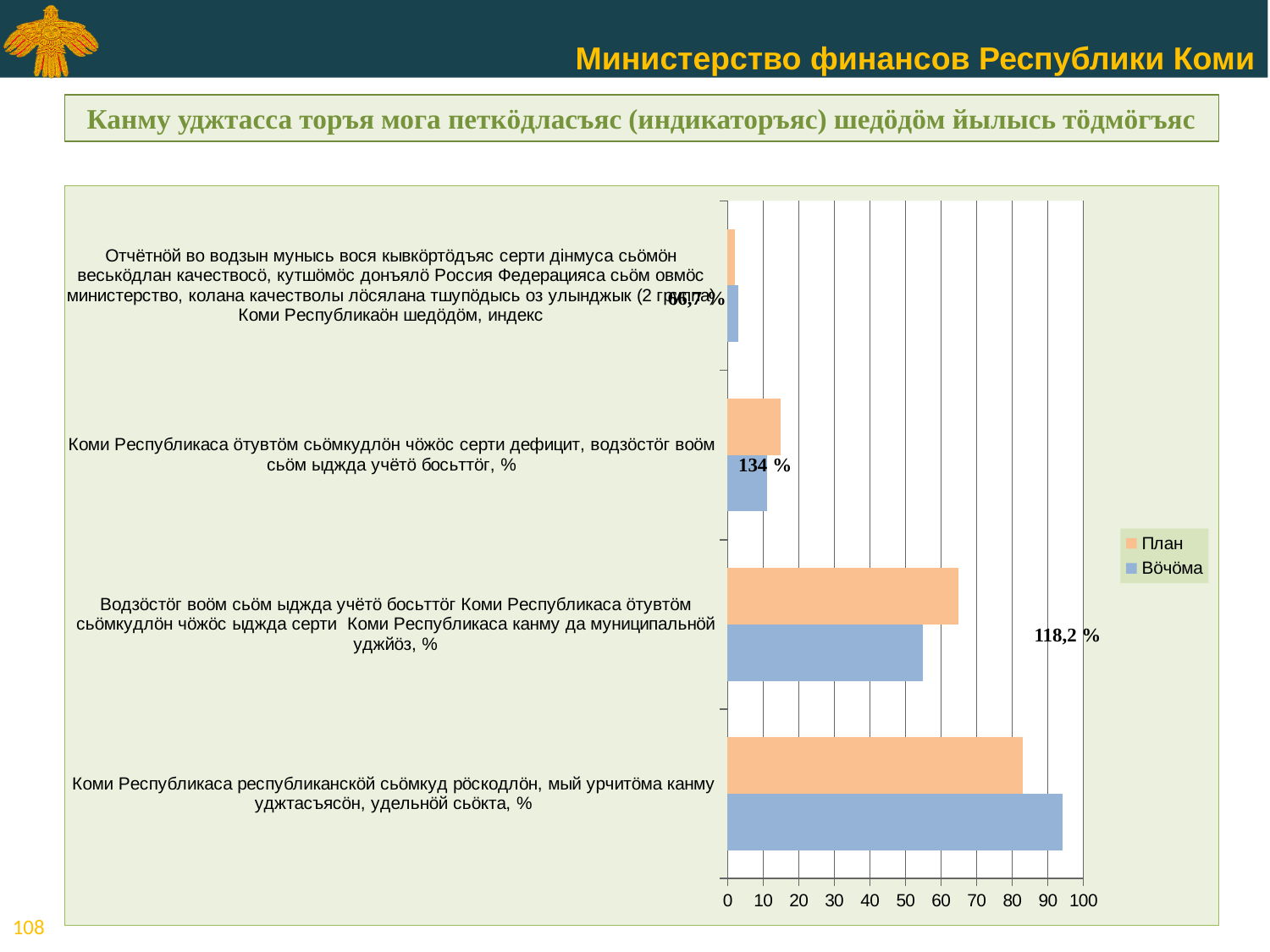
For the category 'Коми Республикаса республиканскöй сьöмкуд рöскодлöн ... удельнöй сьöкта, %', which is larger: План or Вöчöма? Вöчöма Which category has the highest Вöчöма value? Коми Республикаса республиканскöй сьöмкуд рöскодлöн, мый урчитöма канму уджтасъясöн, удельнöй сьöкта, % Which category has the lowest План value? Отчётнöй во водзын мунысь вося кывкöртöдъяс серти дiнмуса сьöмöн веськöдлан качествосö ... Коми Республикаöн шедöдöм, индекс Is the План value for 'Водзöстöг воöм сьöм ыджда учётö босьттöг ... канму да муниципальнöй уджйöз, %' greater or less than 60? greater Is the План value for 'Коми Республикаса öтувтöм сьöмкудлöн чöжöс серти дефицит ... %' greater or less than 20? less What kind of chart is shown on the slide? bar chart Is the Вöчöма value for 'Коми Республикаса республиканскöй сьöмкуд рöскодлöн ... удельнöй сьöкта, %' greater or less than 90? greater For the category 'Водзöстöг воöм сьöм ыджда учётö босьттöг ... канму да муниципальнöй уджйöз, %', which is larger: План or Вöчöма? План Which category has the highest План value? Коми Республикаса республиканскöй сьöмкуд рöскодлöн, мый урчитöма канму уджтасъясöн, удельнöй сьöкта, % What are the two series named in the legend? План and Вöчöма How many series does the legend list? 2 How many categories (indicators) are plotted on the chart? 4